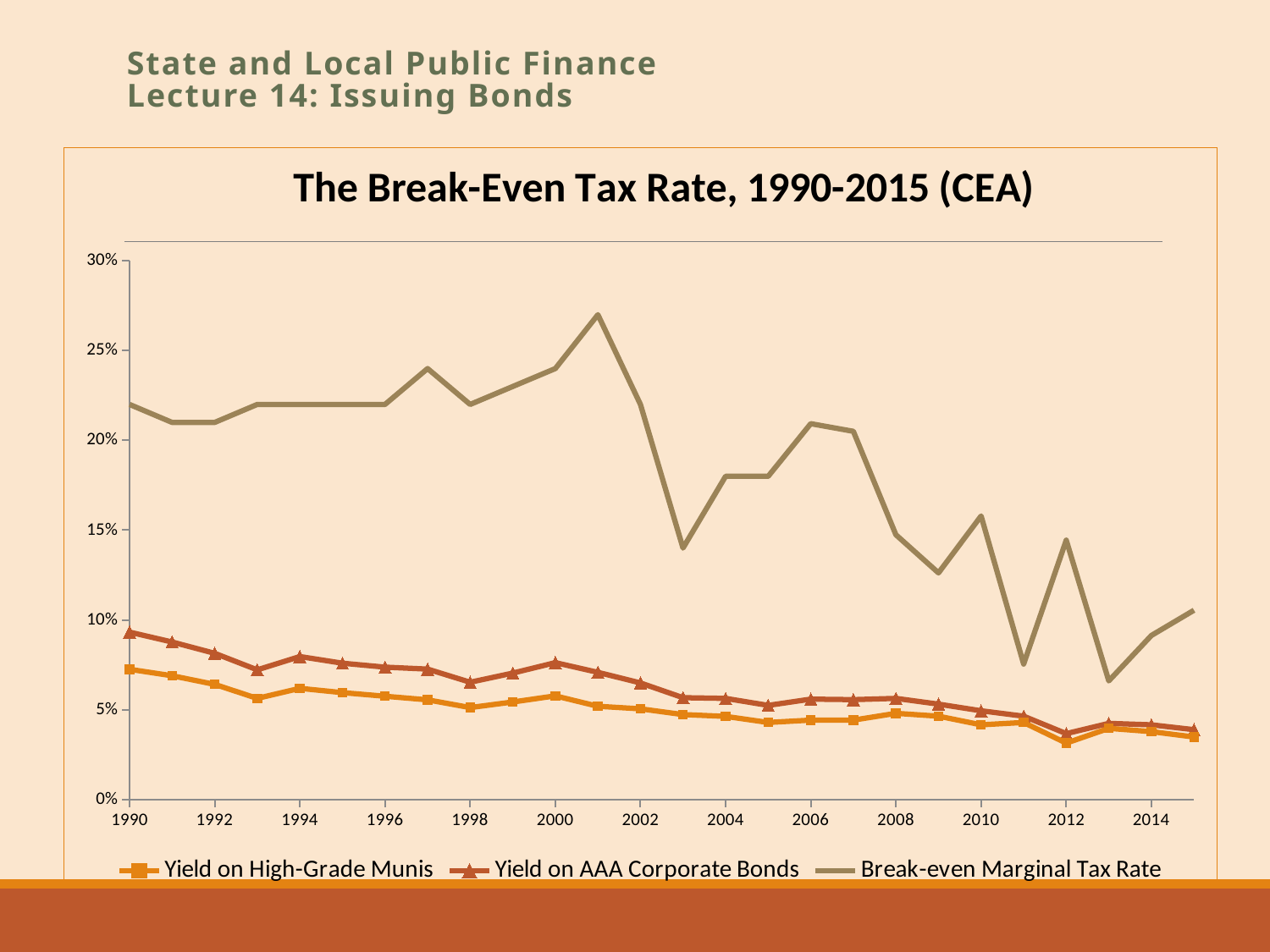
Is the Yield on High-Grade Munis in 2012 greater or less than 5%? less Is the Yield on AAA Corporate Bonds in 1990 greater or less than 10%? less What is the title of the chart? The Break-Even Tax Rate, 1990-2015 (CEA) How many series does the legend list? 3 Is the Break-even Marginal Tax Rate in 2013 greater or less than 10%? less Does the Yield on High-Grade Munis generally rise or fall from 1990 to 2015? fall Which series is plotted with triangle markers? Yield on AAA Corporate Bonds What kind of chart is shown on the slide? line chart Which series is higher in 2006, the Break-even Marginal Tax Rate or the Yield on AAA Corporate Bonds? Break-even Marginal Tax Rate In which year does the Break-even Marginal Tax Rate reach its highest value? 2001 In which year is the Break-even Marginal Tax Rate at its lowest? 2013